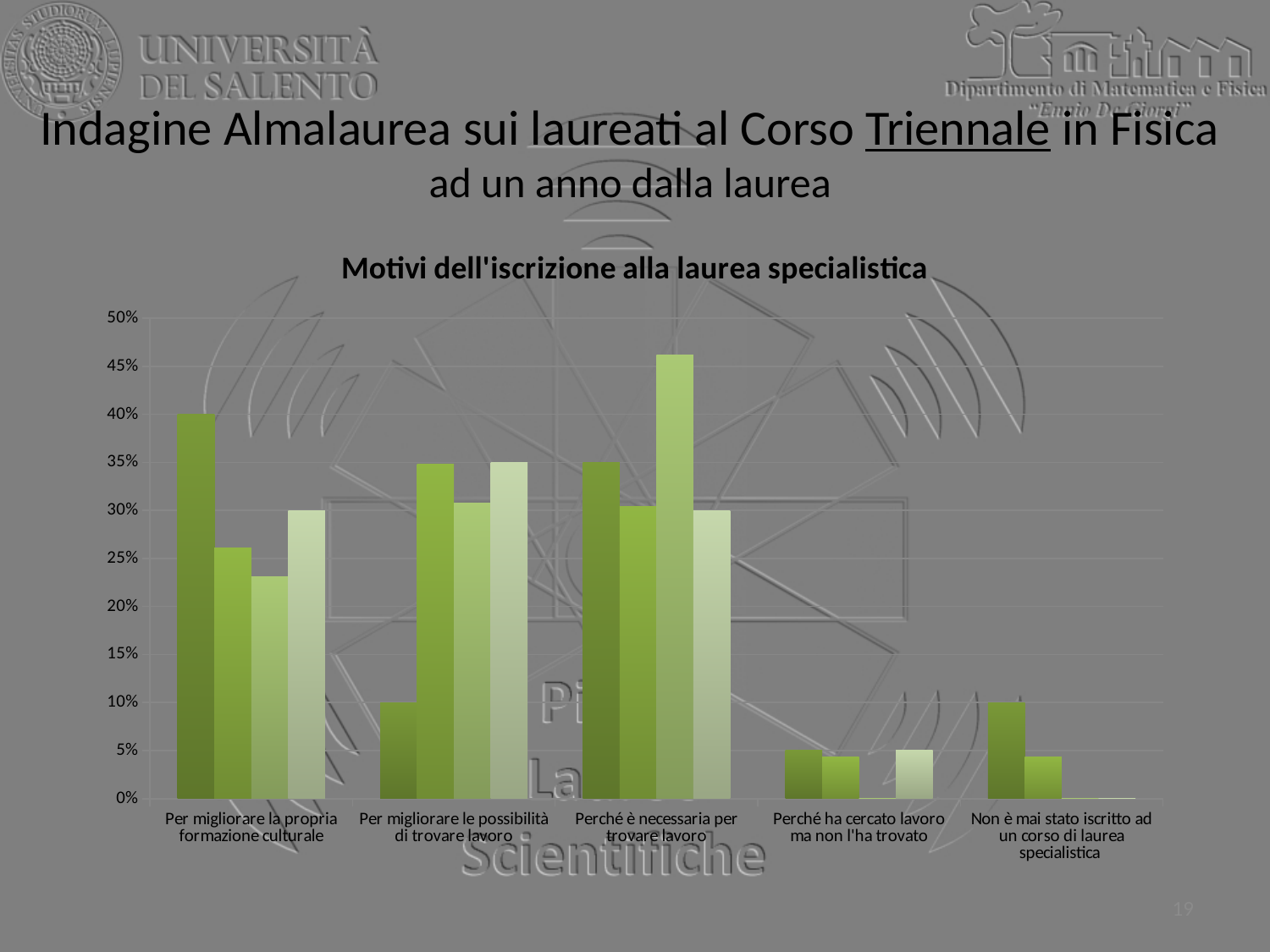
How many categories are shown on the x axis of the chart? 5 How many bars are plotted for the category 'Per migliorare la propria formazione culturale'? 4 Which category contains the tallest bar in the chart? Perché è necessaria per trovare lavoro Is the tallest bar in the category 'Perché è necessaria per trovare lavoro' greater or less than 45%? greater Are all the bars for 'Perché ha cercato lavoro ma non l'ha trovato' greater or less than 10%? less Is the first (darkest green) bar for 'Per migliorare la propria formazione culturale' greater or less than 35%? greater What kind of chart is shown on the slide? bar chart Which is larger: the first (darkest green) bar for 'Per migliorare la propria formazione culturale' or the first (darkest green) bar for 'Non è mai stato iscritto ad un corso di laurea specialistica'? Per migliorare la propria formazione culturale What is the title of the chart? Motivi dell'iscrizione alla laurea specialistica What is the highest value shown on the vertical axis of the chart? 50%